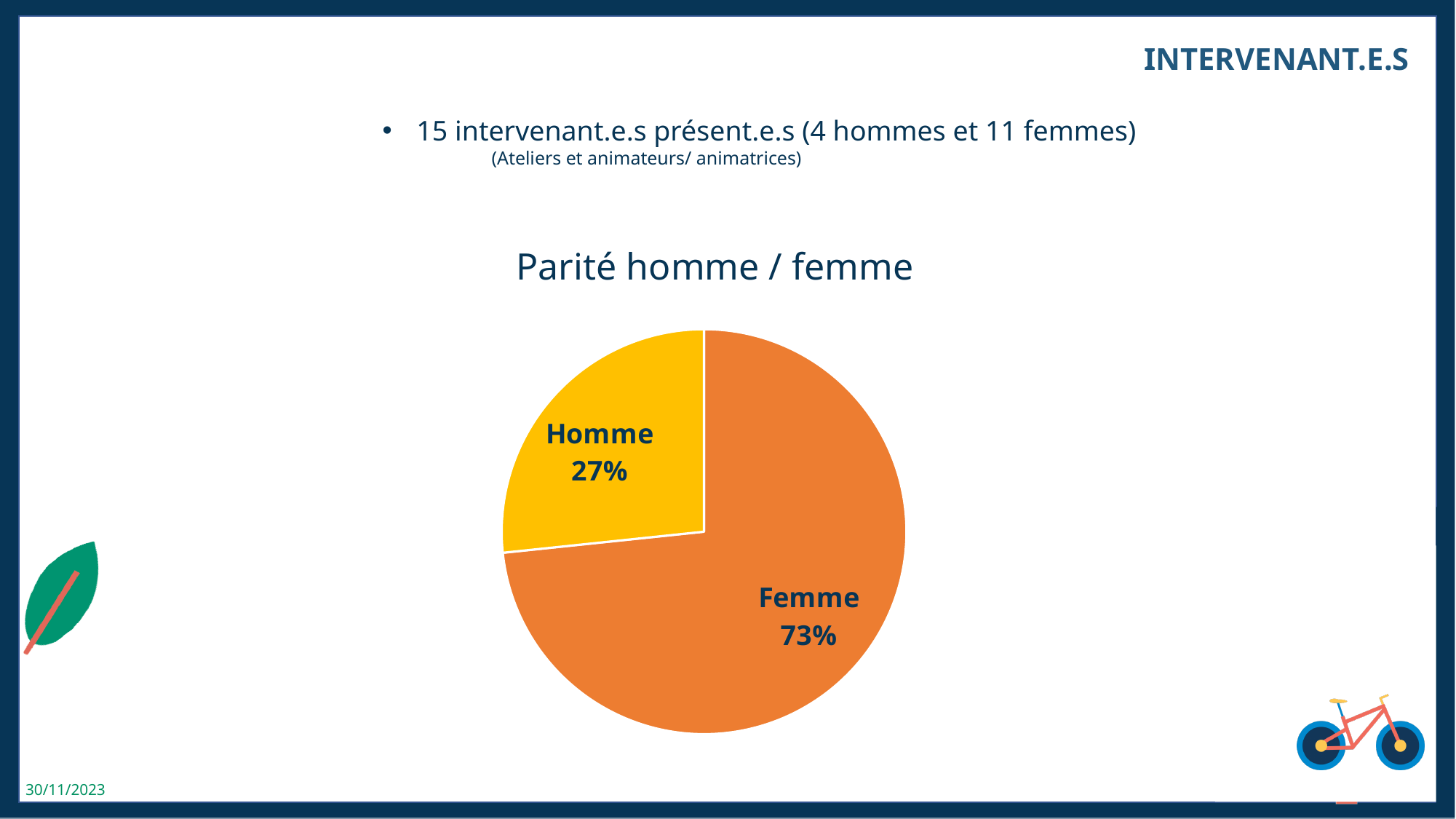
What colour is the Homme slice? yellow Which slice is the smallest in the pie chart? Homme What share of the pie does the Femme slice represent? 73% What kind of chart is shown on the slide? pie chart What is the title of the chart? Parité homme / femme What share of the pie does the Homme slice represent? 27% Which slice is the largest in the pie chart? Femme What is the difference in percentage points between the Femme and Homme slices? 46 Which is larger, the Homme slice or the Femme slice? Femme How many slices does the pie chart have? 2